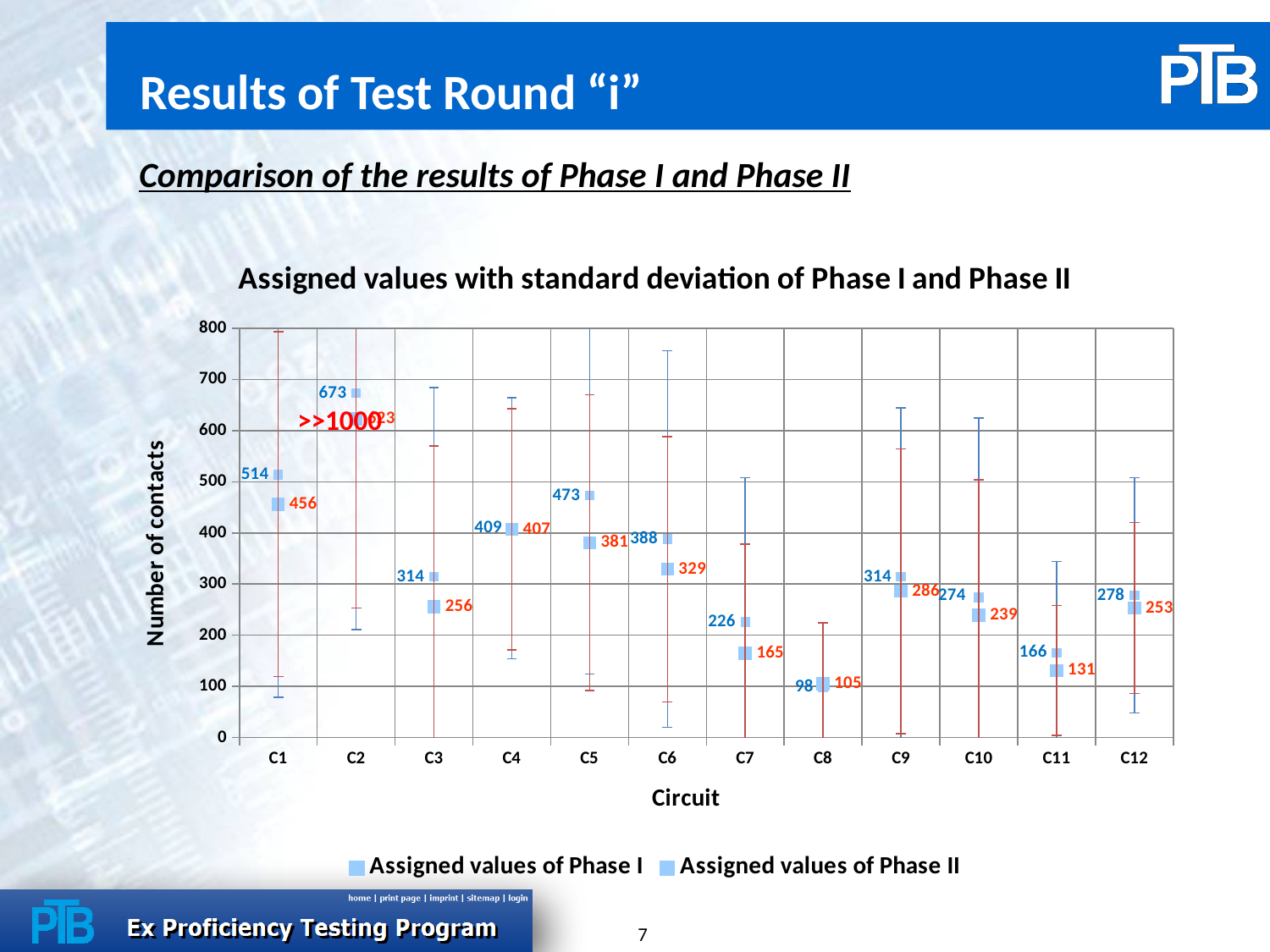
Which circuit has the lowest assigned value of Phase I? C8 What is the title of the chart's vertical axis? Number of contacts What is the assigned value of Phase II for circuit C7? 165 How many circuits are shown on the x axis? 12 What is the assigned value of Phase II for circuit C11? 131 What is the difference between the Phase I and Phase II assigned values for circuit C1? 58 For circuit C8, which is larger: the assigned value of Phase I or of Phase II? Assigned values of Phase II What kind of chart is shown on the slide? Scatter chart with error bars What is the assigned value of Phase I for circuit C5? 473 How many series does the legend list? 2 Which circuit has the highest assigned value of Phase I? C2 What is the assigned value of Phase I for circuit C1? 514